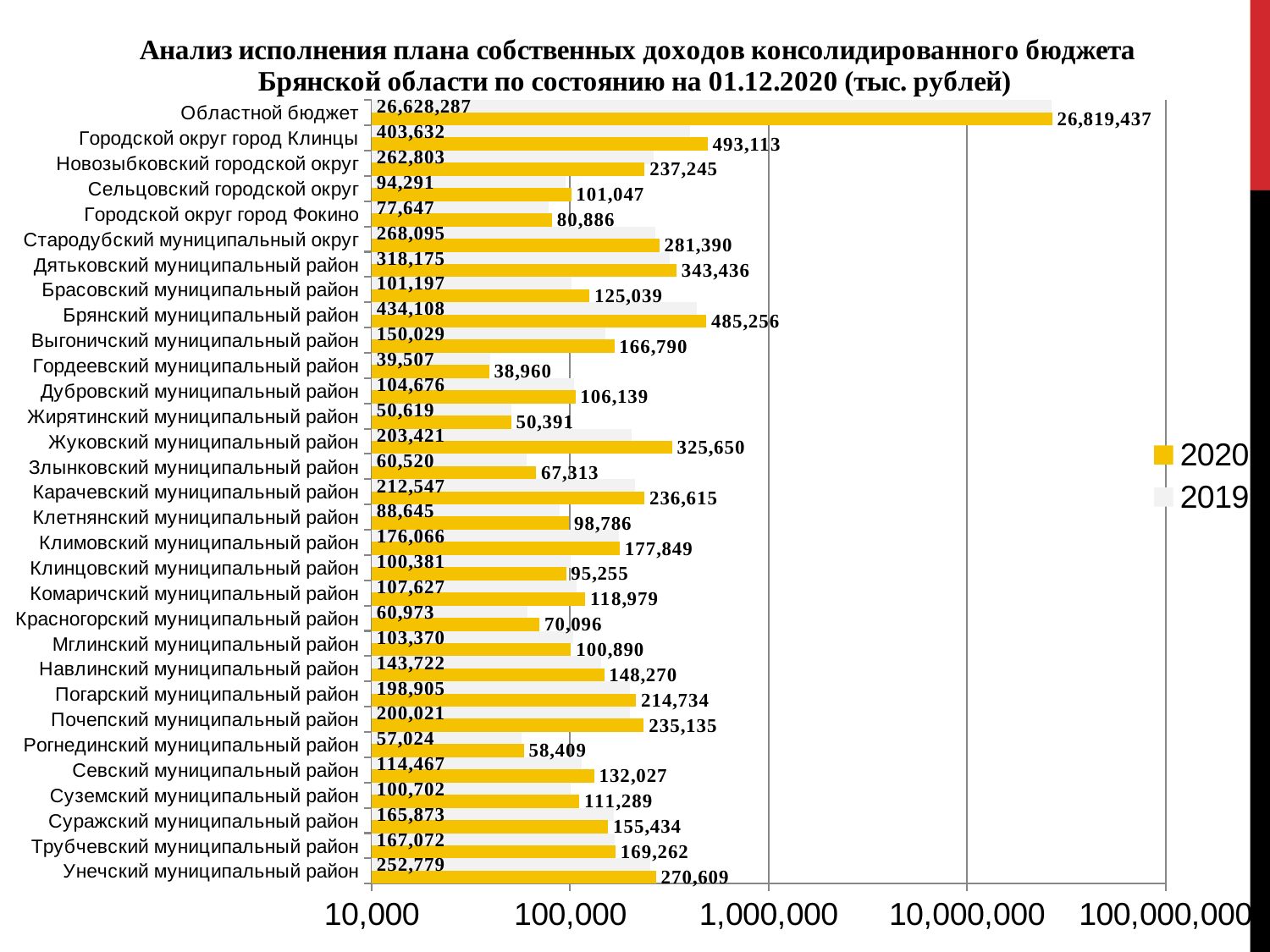
What is the difference between the 2020 and 2019 values for Жуковский муниципальный район? 122,229 What kind of chart is shown on the slide? Bar chart How many series does the legend list? 2 What is the 2019 value for Жуковский муниципальный район? 203,421 For Суражский муниципальный район, which year has the larger value, 2019 or 2020? 2019 What is the 2020 value for Брянский муниципальный район? 485,256 What is the 2019 value for Сельцовский городской округ? 94,291 Which category has the highest 2020 value? Областной бюджет For Клинцовский муниципальный район, which year has the larger value, 2019 or 2020? 2019 By how much does the 2020 value for Областной бюджет exceed its 2019 value? 191,150 What is the 2020 value for Унечский муниципальный район? 270,609 Which category has the lowest 2020 value? Гордеевский муниципальный район